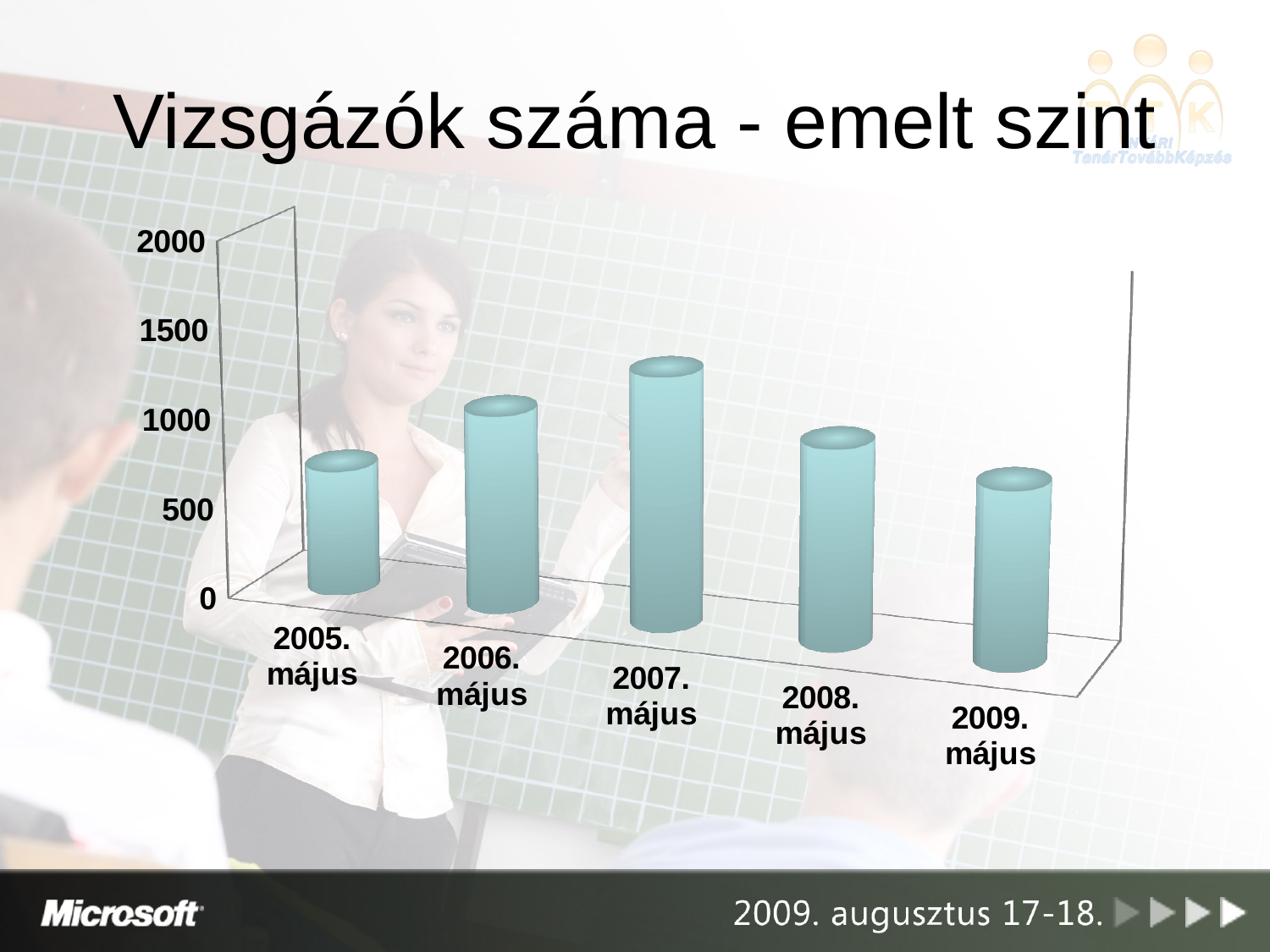
Is the value for 2005. május greater or less than 1000? less Do the values rise or fall from 2007. május to 2009. május? fall Which category has the highest value in the chart? 2007. május What is the title of the chart? Vizsgázók száma - emelt szint Which category has the lowest value in the chart? 2005. május Is the value for 2009. május greater or less than 500? greater What is the highest value shown on the vertical axis of the chart? 2000 Which is larger, the value for 2007. május or the value for 2009. május? 2007. május What kind of chart is shown on the slide? bar chart Is the value for 2007. május greater or less than 1000? greater How many categories are shown on the x axis of the chart? 5